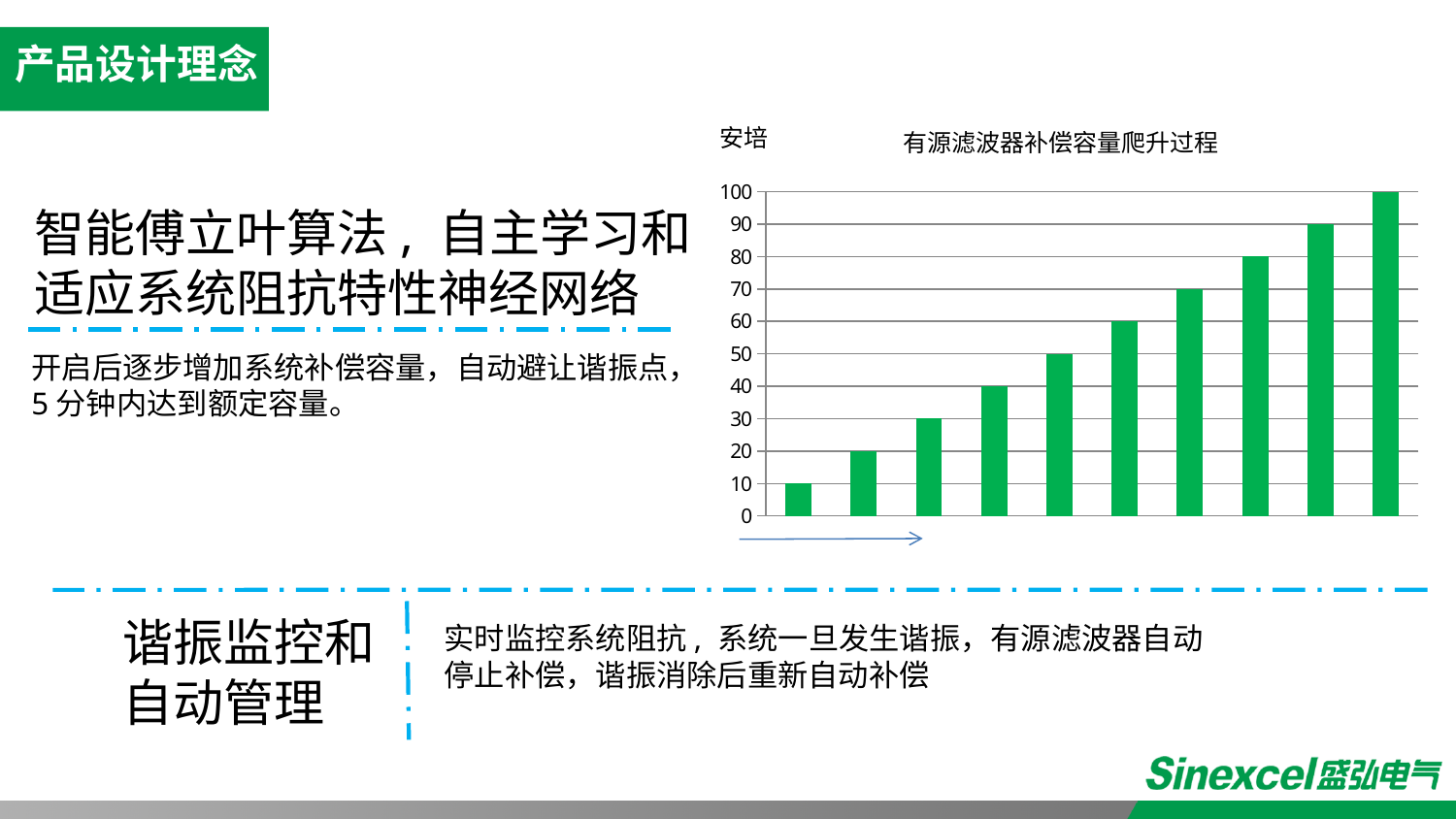
What is the value of the last (rightmost) bar in the chart? 100 What is the title of the chart on the slide? 有源滤波器补偿容量爬升过程 Which bar has the lowest value in the chart? the leftmost (first) bar Which bar has the highest value in the chart? the rightmost (tenth) bar What is the difference between the rightmost bar and the leftmost bar in the chart? 90 Is the value of the third bar from the left greater or less than 50? less What is the value of the fifth bar from the left in the chart? 50 How many bars are plotted in the chart? 10 What type of chart is shown on the slide? bar chart What is the value of the first (leftmost) bar in the chart? 10 What unit label is shown above the y axis of the chart? 安培 Do the bar values rise or fall from left to right along the x axis? rise